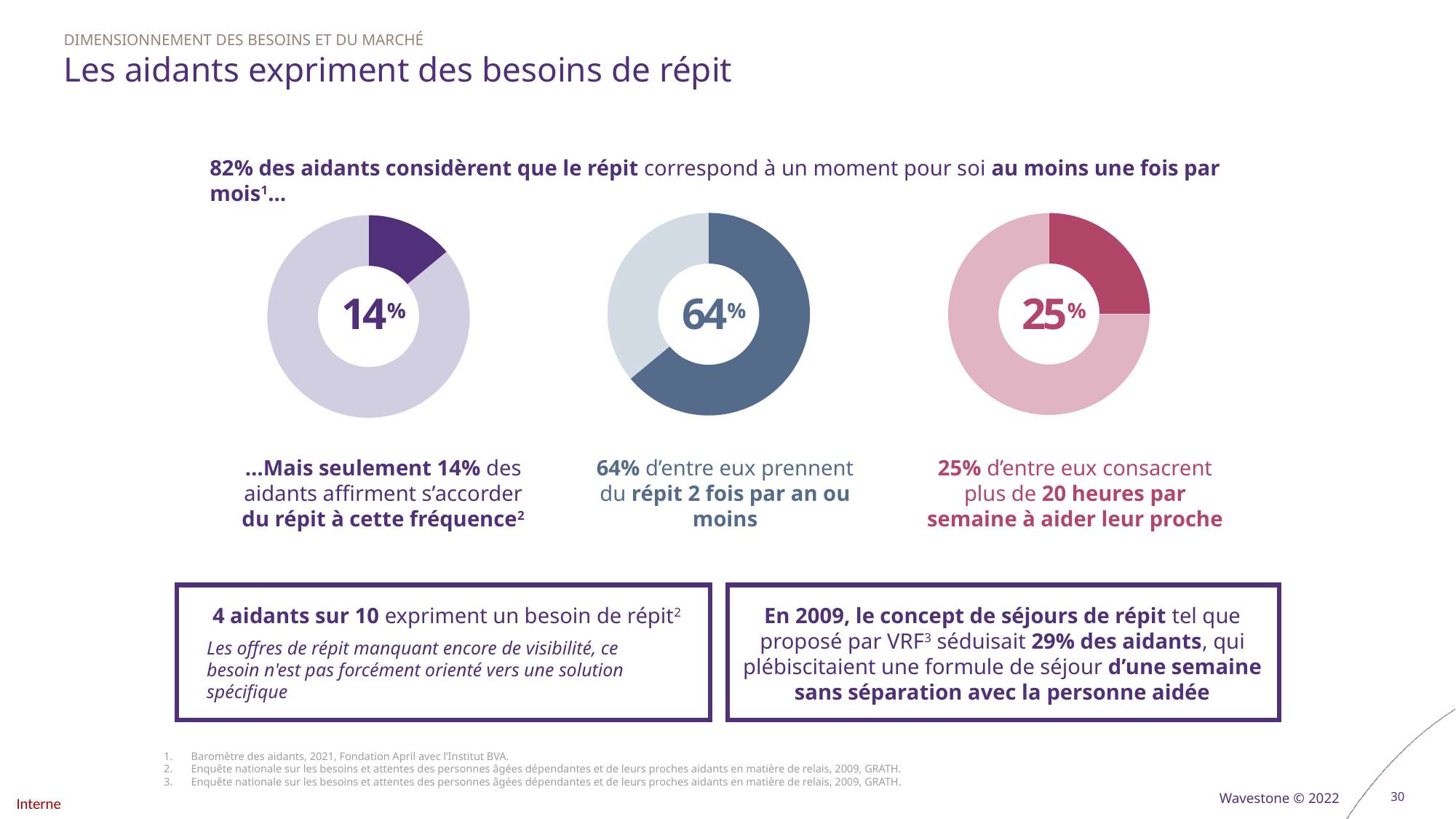
What value is shown in the centre of the middle donut chart? 64% Is the value in the right donut chart larger or smaller than the value in the middle donut chart? Smaller Which of the three donut charts shows the lowest percentage? The left chart (14%) What is the difference between the value in the right donut chart and the value in the left donut chart? 11 percentage points How many donut charts are on the slide? 3 What value is shown in the centre of the left donut chart? 14% What is the difference between the value in the middle donut chart and the value in the left donut chart? 50 percentage points What colour is the highlighted slice of the right donut chart? Dark pink/red Is the value shown in the middle donut chart greater or less than 50%? greater What kind of charts are shown on the slide? Donut (pie) charts What value is shown in the centre of the right donut chart? 25% Which of the three donut charts shows the highest percentage? The middle chart (64%)